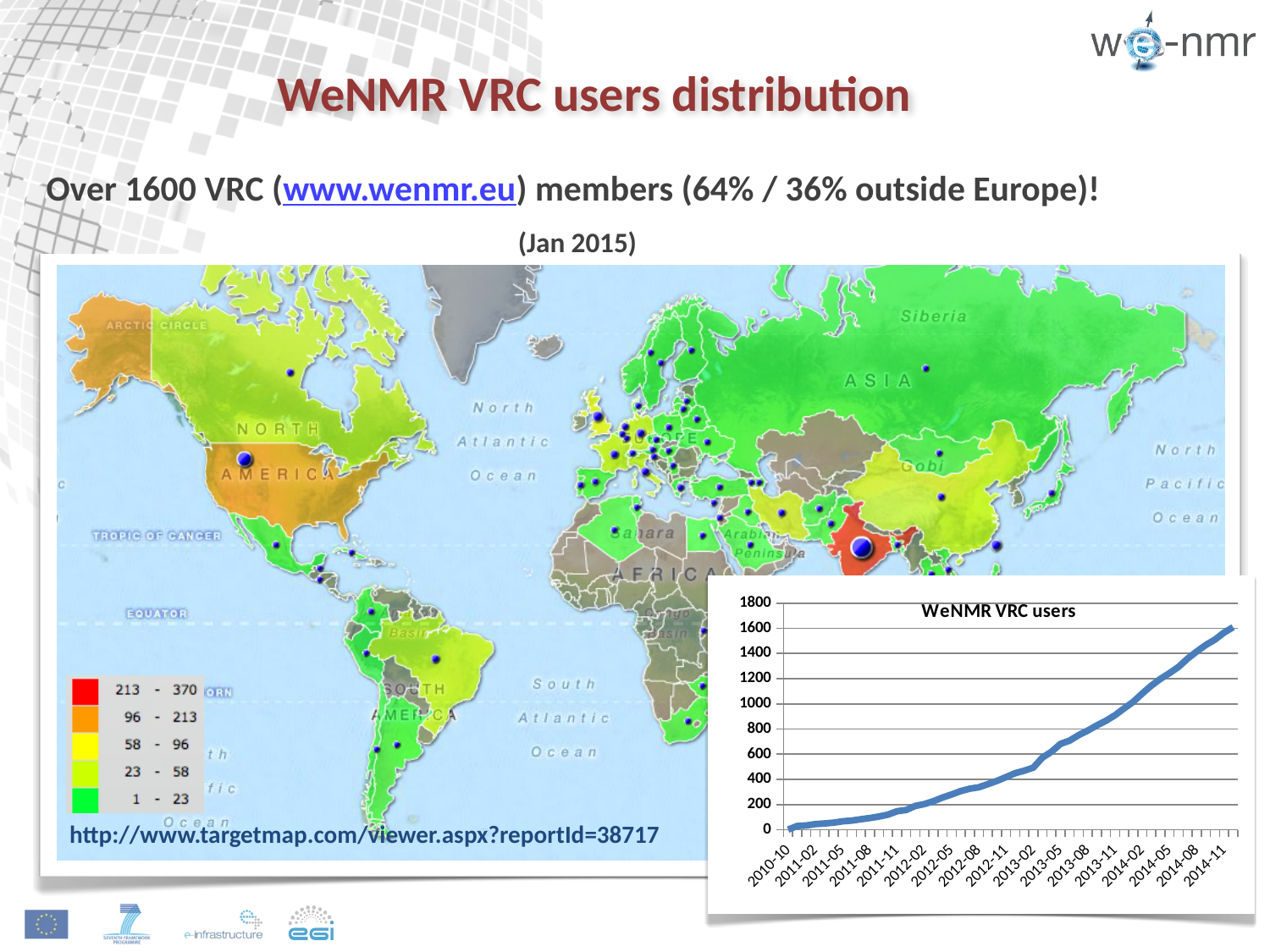
What kind of chart is the 'WeNMR VRC users' chart in the lower right of the slide? line chart In the 'WeNMR VRC users' chart, is the value at 2014-11 greater or less than 1400? greater In the 'WeNMR VRC users' chart, at which x-axis label is the value highest? 2014-11 In the 'WeNMR VRC users' chart, do the values rise or fall over time along the x axis? rise In the 'WeNMR VRC users' chart, is the value at 2012-02 greater or less than 400? less How many colour ranges does the legend of the world map list? 5 In the 'WeNMR VRC users' chart, which has the larger value: 2014-11 or 2011-05? 2014-11 What is the highest value shown on the y axis of the 'WeNMR VRC users' chart? 1800 What is the title of the line chart on the slide? WeNMR VRC users In the 'WeNMR VRC users' chart, at which x-axis label is the value lowest? 2010-10 In the 'WeNMR VRC users' chart, is the value at 2011-05 greater or less than 200? less